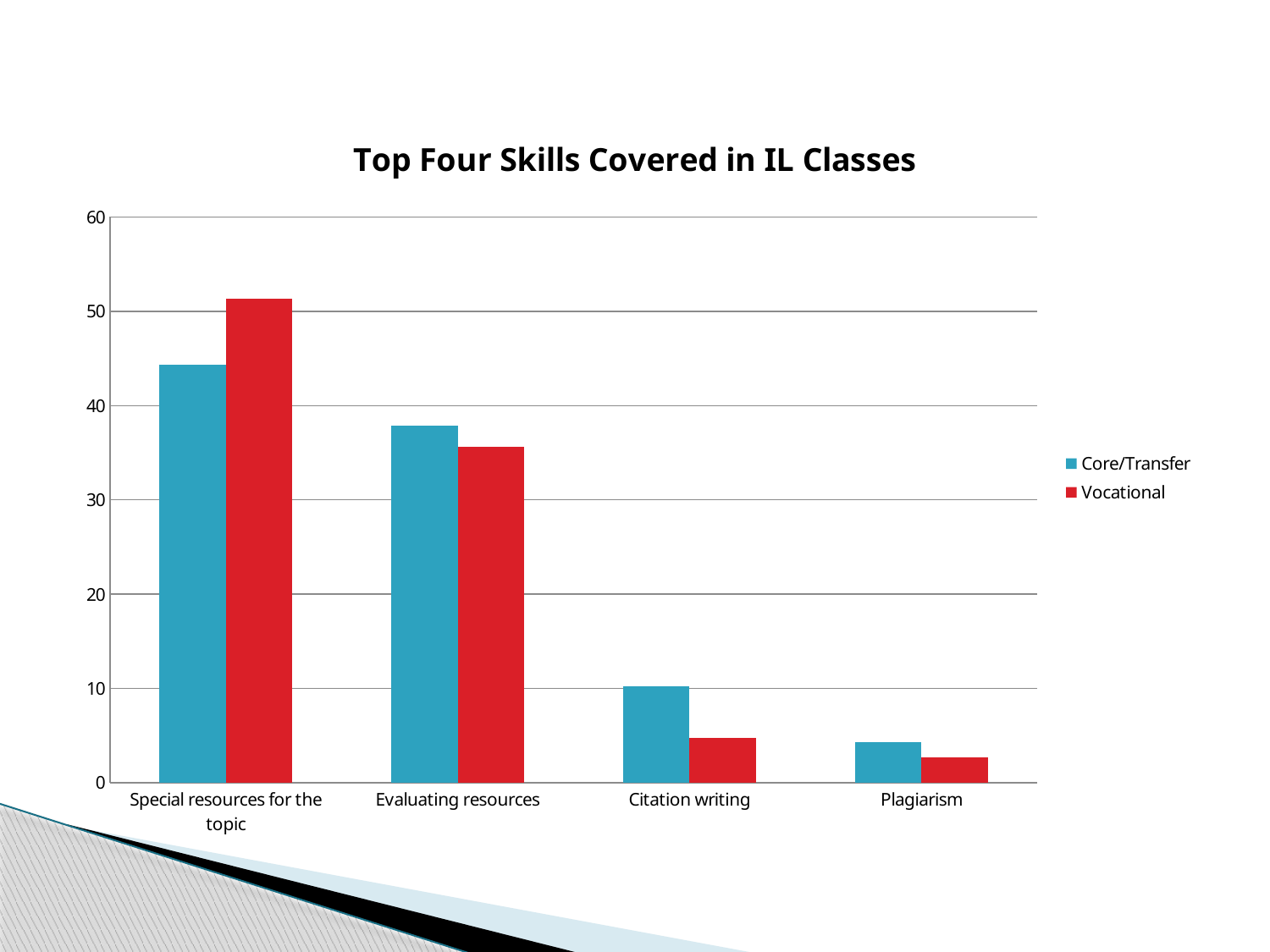
Is the Vocational value for Citation writing greater or less than 10? less How many skill categories are shown on the x axis? 4 For Citation writing, which series has the larger value, Core/Transfer or Vocational? Core/Transfer For Special resources for the topic, which series has the larger value, Core/Transfer or Vocational? Vocational Which category has the highest Core/Transfer value? Special resources for the topic Which category has the lowest Vocational value? Plagiarism Do the Core/Transfer values rise or fall moving from left to right across the categories? fall What is the title of the chart? Top Four Skills Covered in IL Classes Is the Core/Transfer value for Evaluating resources greater or less than 40? less What type of chart is shown on the slide? Bar chart Is the Vocational value for Special resources for the topic greater or less than 50? greater How many series does the legend list? 2